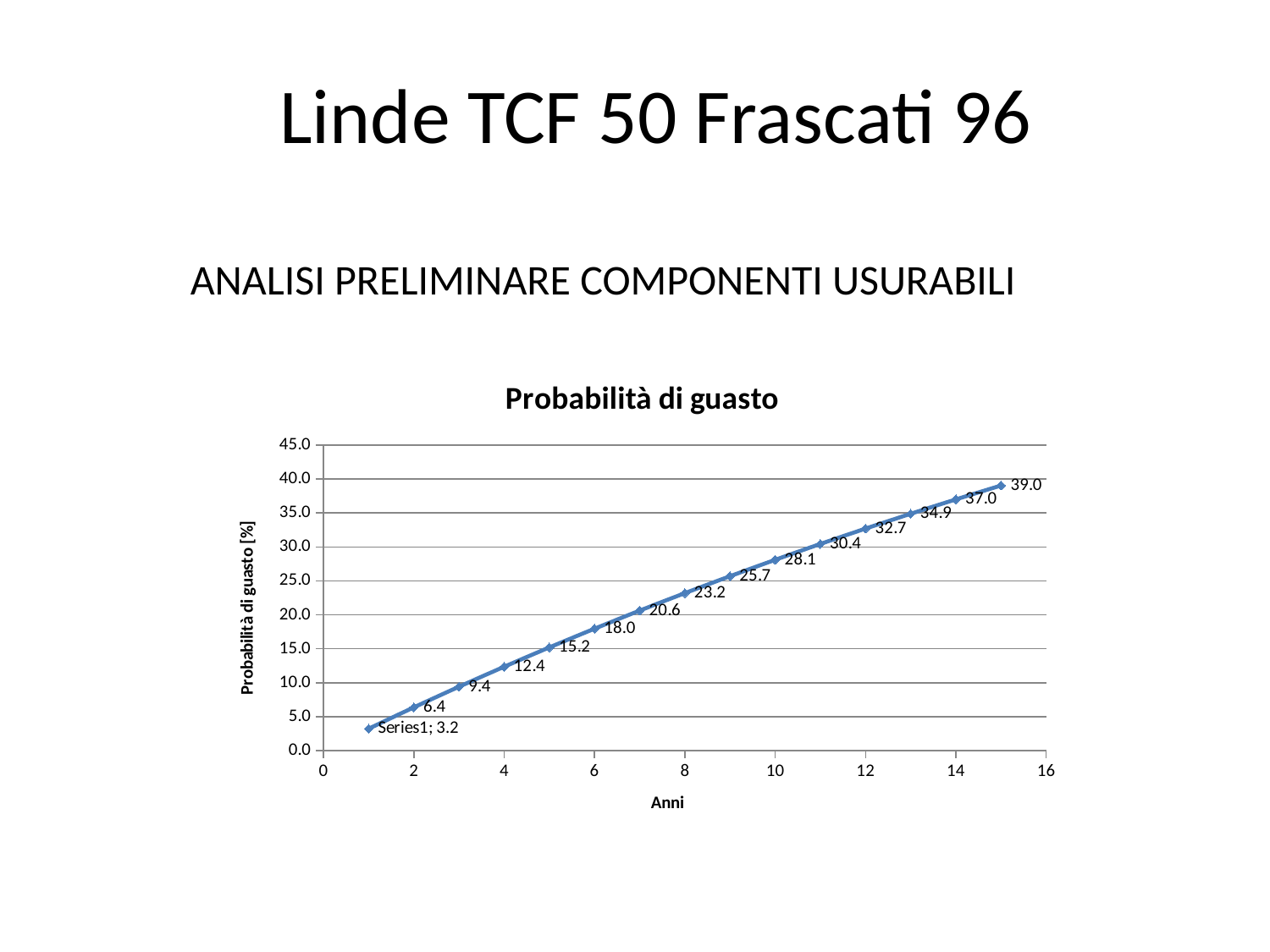
What is the label of the x axis? Anni What is the difference between the probability of failure at year 15 and at year 1? 35.8 Do the values rise or fall as the years increase? rise What is the title of the chart? Probabilità di guasto What is the value of the probability of failure at year 1? 3.2 What type of chart is shown on the slide? line chart How many data points are plotted on the chart? 15 What is the value of the probability of failure at year 15? 39.0 What is the value of the probability of failure at year 5? 15.2 Which year has the lowest probability of failure? 1 Which year has the highest probability of failure? 15 What is the value of the probability of failure at year 10? 28.1